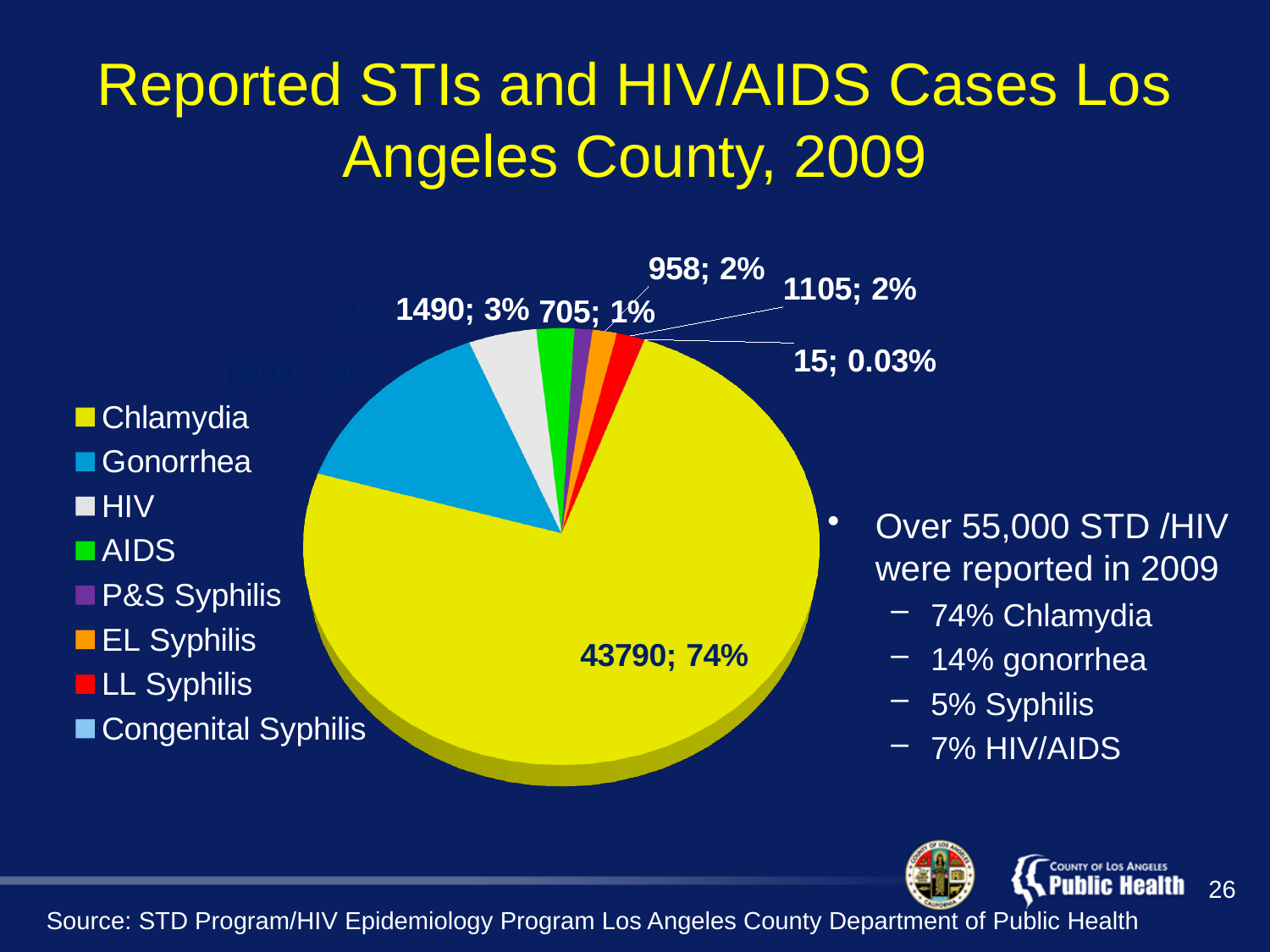
Which category has the smallest slice of the pie chart? Congenital Syphilis What is the difference between the Chlamydia count and the AIDS count on the pie chart? 42300 What share of the pie does P&S Syphilis account for? 1% What colour represents Chlamydia in the pie chart legend? yellow What is the number of AIDS cases shown on the pie chart? 1490 What share of the pie does Chlamydia account for? 74% What is the number of reported Chlamydia cases shown on the pie chart? 43790 Which is larger on the pie chart, Chlamydia or Gonorrhea? Chlamydia What kind of chart is shown on the slide? pie chart How many categories does the legend of the pie chart list? 8 What value is shown for the smallest slice of the pie chart? 15; 0.03% Which category has the largest slice of the pie chart? Chlamydia